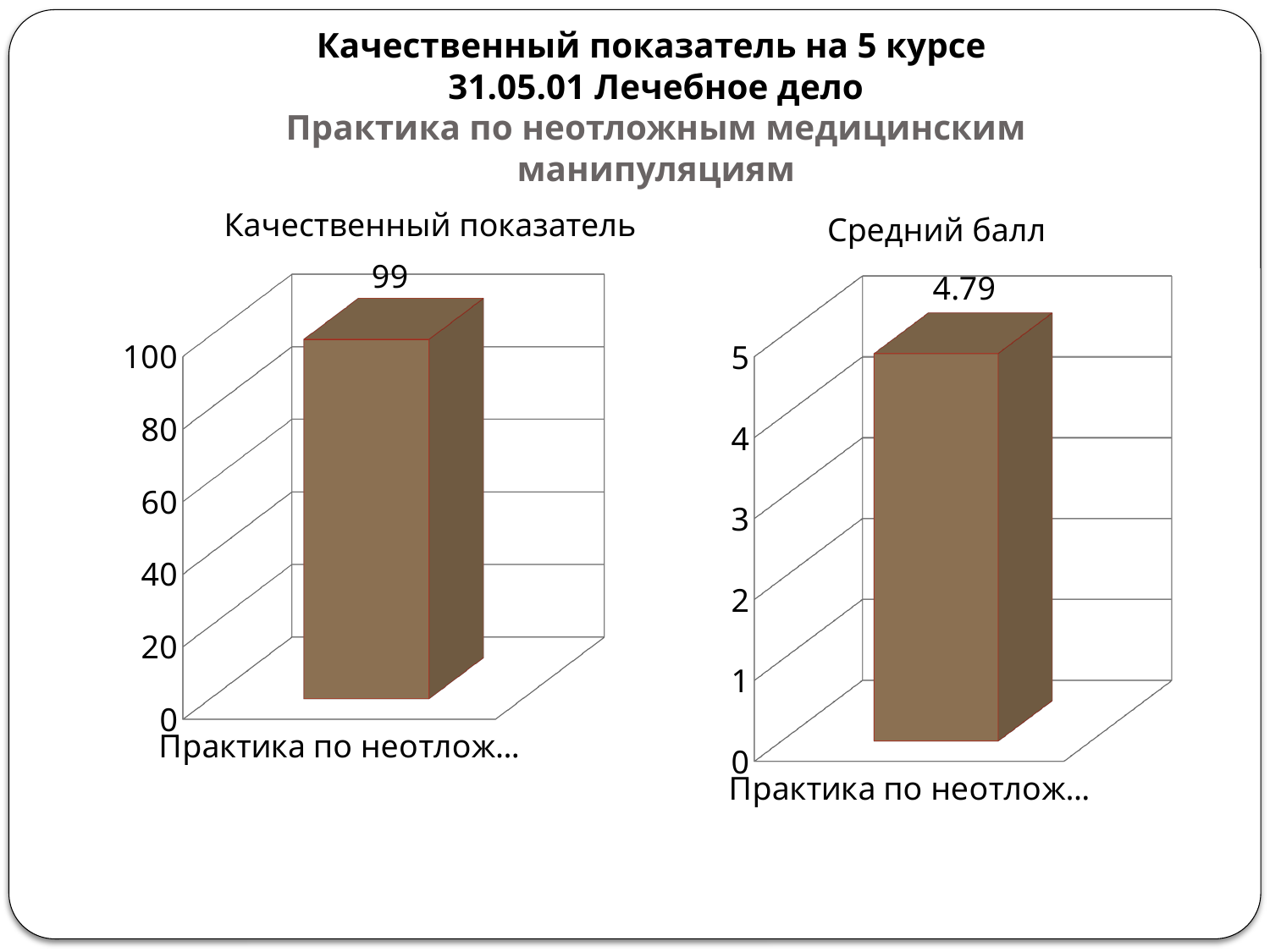
What is the highest tick value shown on the vertical axis of the chart titled "Средний балл"? 5 What kind of chart is the right chart, "Средний балл"? bar chart How many bars are plotted in the chart titled "Средний балл"? 1 In the chart titled "Качественный показатель", is the value of the bar greater or less than 80? greater In the chart titled "Средний балл", what value is printed on the bar? 4.79 How many bars are plotted in the chart titled "Качественный показатель"? 1 What is the highest tick value shown on the vertical axis of the chart titled "Качественный показатель"? 100 In the chart titled "Средний балл", is the value of the bar greater or less than 4? greater What kind of chart is the left chart, "Качественный показатель"? bar chart In the chart titled "Качественный показатель", what value is printed on the bar? 99